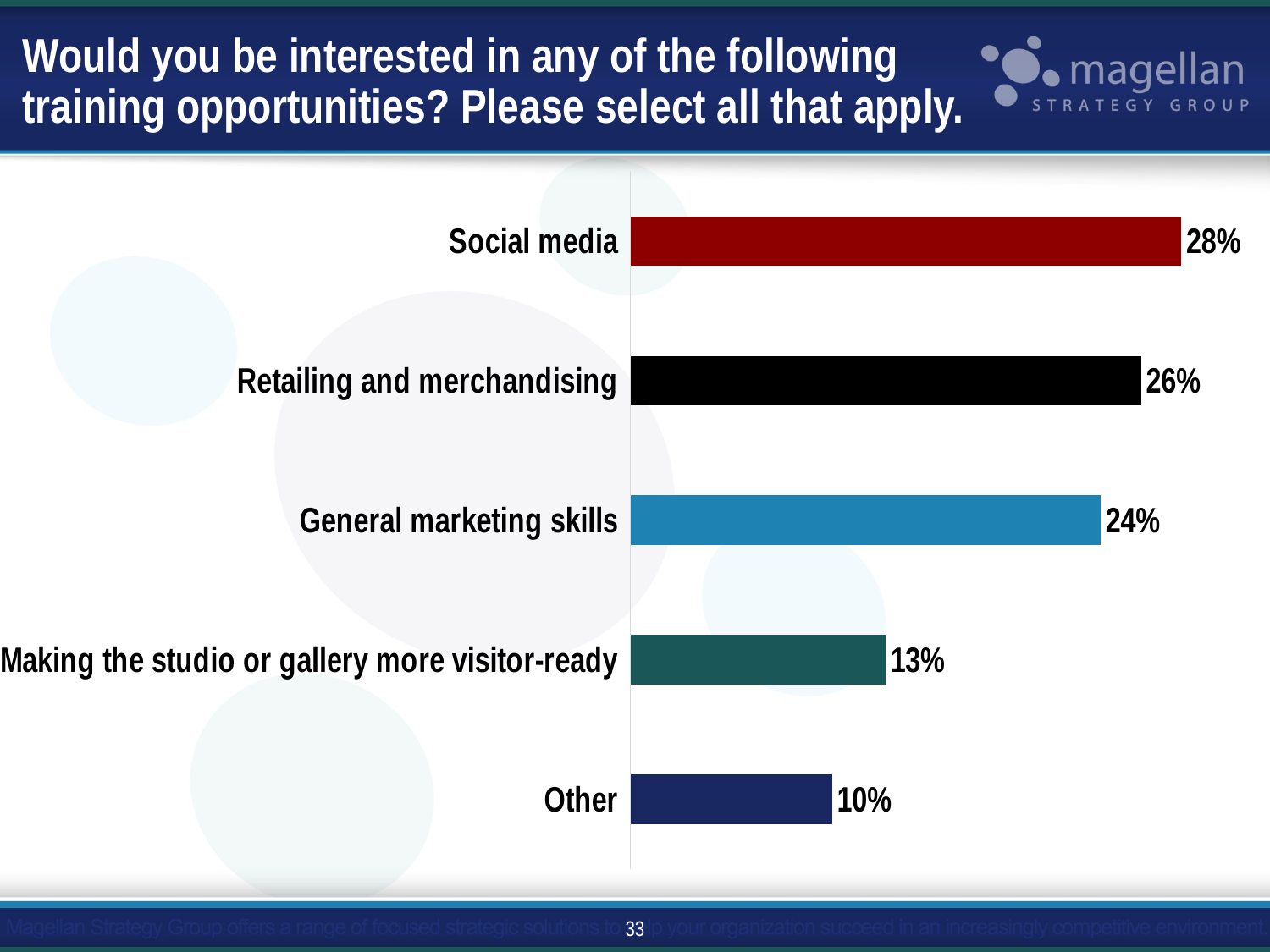
What is the value for Retailing and merchandising? 26% Which category has the lowest value? Other What is the difference between the values for Social media and Other? 18% What is the value for Making the studio or gallery more visitor-ready? 13% What is the value for General marketing skills? 24% What is the value for Other? 10% What kind of chart is shown on the slide? Bar chart What percentage of respondents were interested in Social media training? 28% How many categories are shown in the chart? 5 Which is larger, the value for Retailing and merchandising or the value for General marketing skills? Retailing and merchandising Which training opportunity has the highest value? Social media What is the difference between General marketing skills and Making the studio or gallery more visitor-ready? 11%